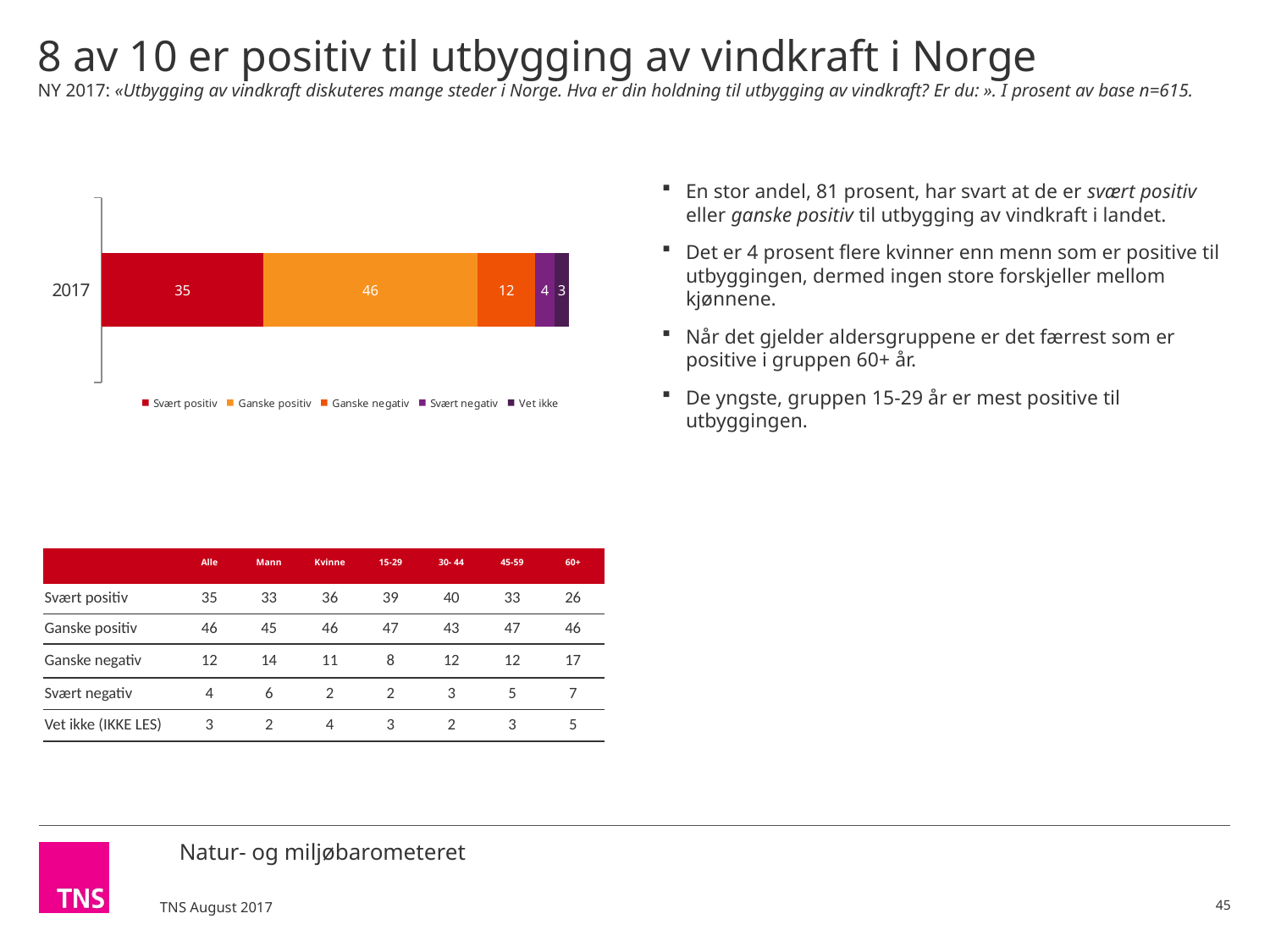
What is the value of the Svært negativ segment in the 2017 bar? 4 How many series does the chart legend list? 5 What is the value of the Svært positiv segment in the 2017 bar? 35 What is the value of the Vet ikke segment in the 2017 bar? 3 What is the value of the Ganske negativ segment in the 2017 bar? 12 What is the total of all segments in the 2017 bar? 100 Which segment of the 2017 bar has the smallest value? Vet ikke What is the difference between the Ganske positiv and Svært positiv values in the 2017 bar? 11 What is the value of the Ganske positiv segment in the 2017 bar? 46 Which segment of the 2017 bar has the largest value? Ganske positiv What kind of chart is shown on the slide? Stacked bar chart Which category label is shown on the vertical axis of the chart? 2017